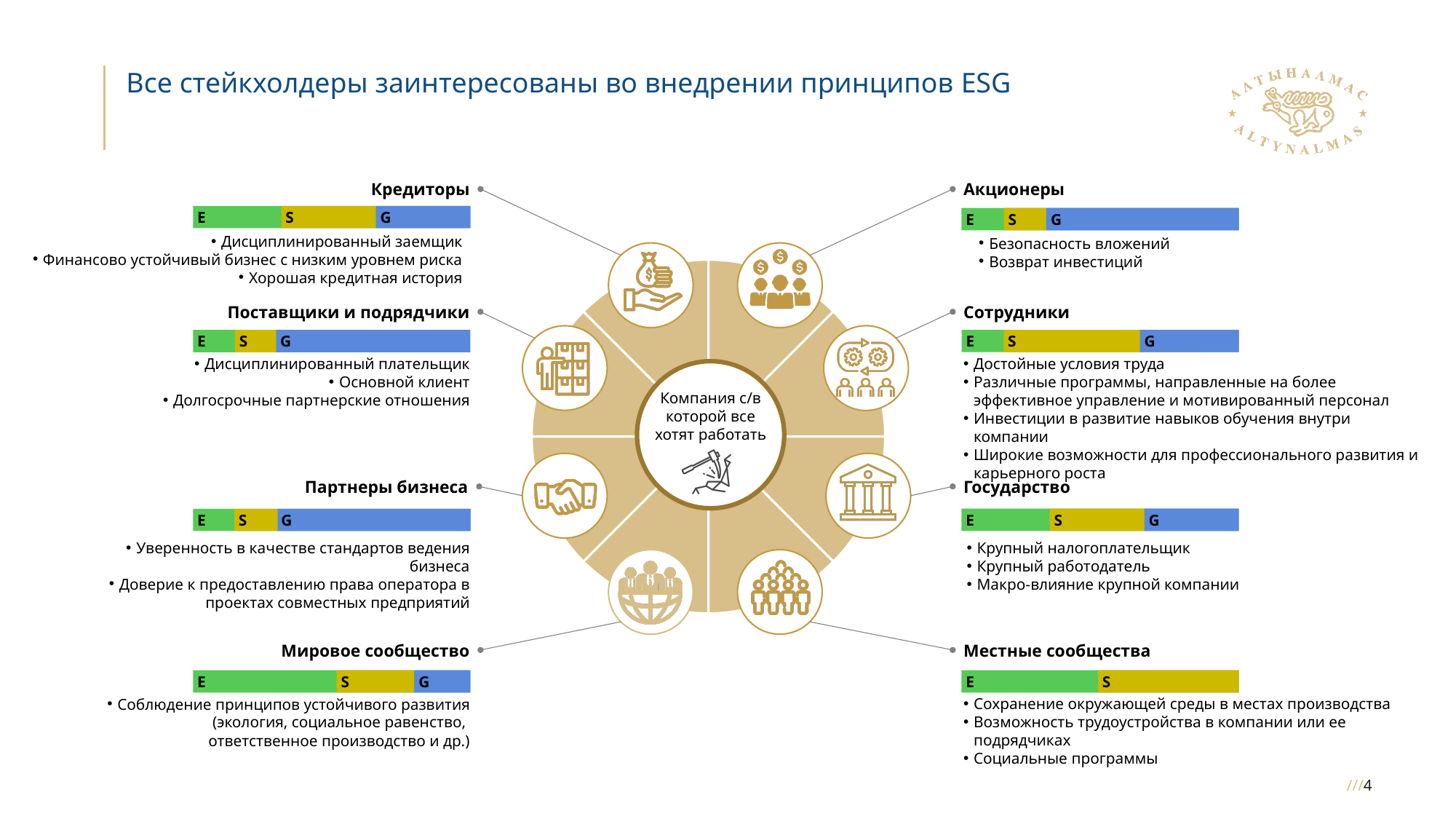
In the bar for "Партнеры бизнеса", which segment is larger, S or G? G In the bar for "Мировое сообщество", which segment is the largest? E What colour is the S segment in the bars on the slide? Yellow In the bar for "Сотрудники", which segment is the smallest? E In the bar for "Мировое сообщество", which segment is the smallest? G In the bar for "Поставщики и подрядчики", which segment is larger, E or G? G In the bar for "Сотрудники", which segment is the largest? S How many stakeholder groups have an E/S/G bar on the slide? 8 How many segments does the bar for "Местные сообщества" contain? 2 What kind of chart is used next to each stakeholder group on the slide? Stacked bar chart Which segment is missing from the bar for "Местные сообщества"? G In the bar for "Акционеры", which segment is the largest? G